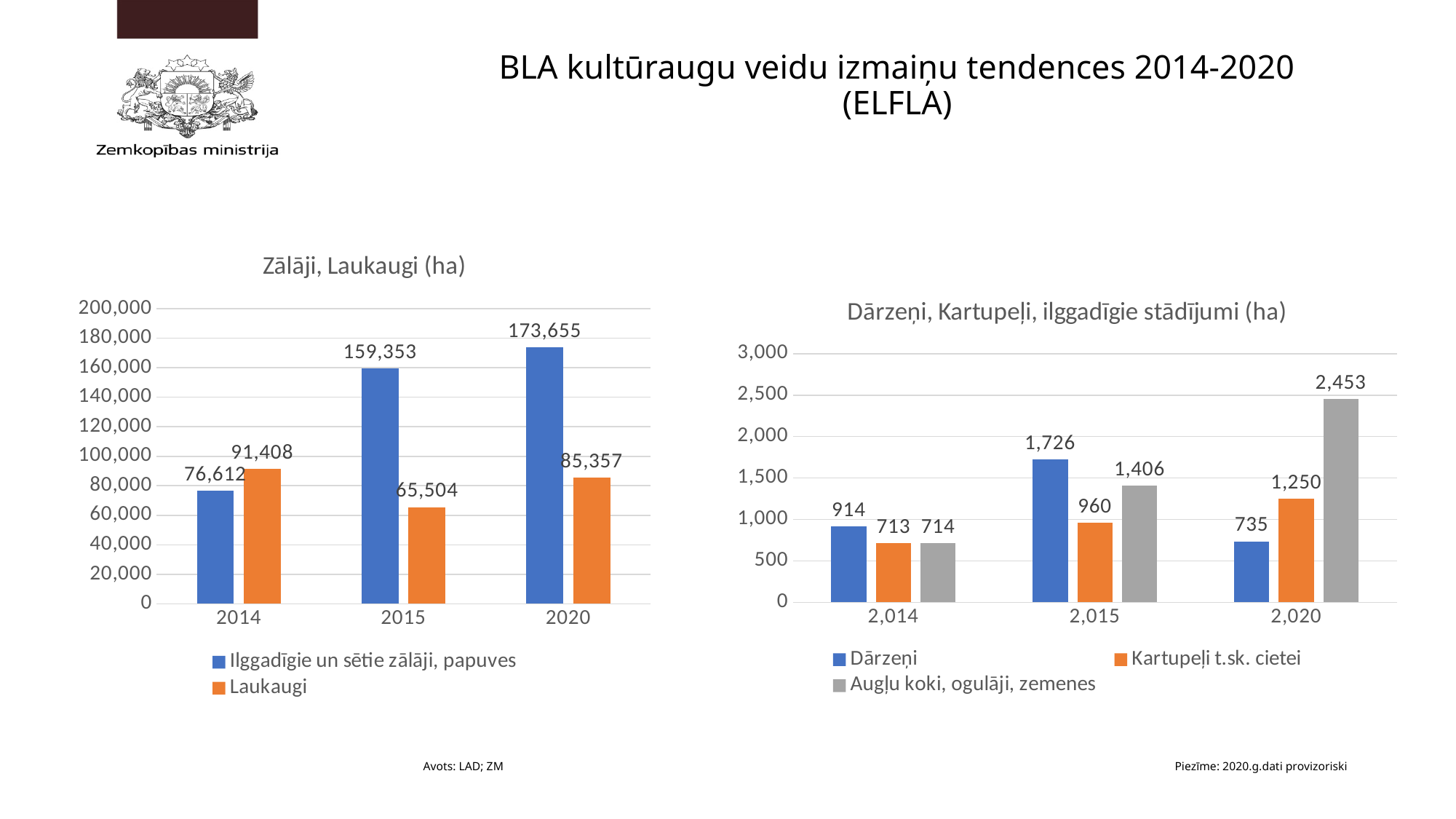
In the chart titled "Dārzeņi, Kartupeļi, ilggadīgie stādījumi (ha)", what is the difference between the Augļu koki, ogulāji, zemenes value in 2,020 and in 2,015? 1,047 How many series does the legend of the chart titled "Dārzeņi, Kartupeļi, ilggadīgie stādījumi (ha)" list? 3 What kind of chart is the chart titled "Zālāji, Laukaugi (ha)"? bar chart In the chart titled "Dārzeņi, Kartupeļi, ilggadīgie stādījumi (ha)", what is the value for Kartupeļi t.sk. cietei in 2,015? 960 In the chart titled "Dārzeņi, Kartupeļi, ilggadīgie stādījumi (ha)", in which year is the Dārzeņi value lowest? 2,020 In the chart titled "Zālāji, Laukaugi (ha)", which is larger in 2014: Ilggadīgie un sētie zālāji, papuves or Laukaugi? Laukaugi In the chart titled "Zālāji, Laukaugi (ha)", what is the difference between the Ilggadīgie un sētie zālāji, papuves value in 2020 and in 2015? 14,302 In the chart titled "Zālāji, Laukaugi (ha)", what is the value for Laukaugi in 2015? 65,504 In the chart titled "Zālāji, Laukaugi (ha)", in which year is the Laukaugi value highest? 2014 In the chart titled "Zālāji, Laukaugi (ha)", does the Ilggadīgie un sētie zālāji, papuves value rise or fall from 2014 to 2020? rise In the chart titled "Dārzeņi, Kartupeļi, ilggadīgie stādījumi (ha)", what is the value for Augļu koki, ogulāji, zemenes in 2,020? 2,453 In the chart titled "Zālāji, Laukaugi (ha)", what is the value for Ilggadīgie un sētie zālāji, papuves in 2020? 173,655